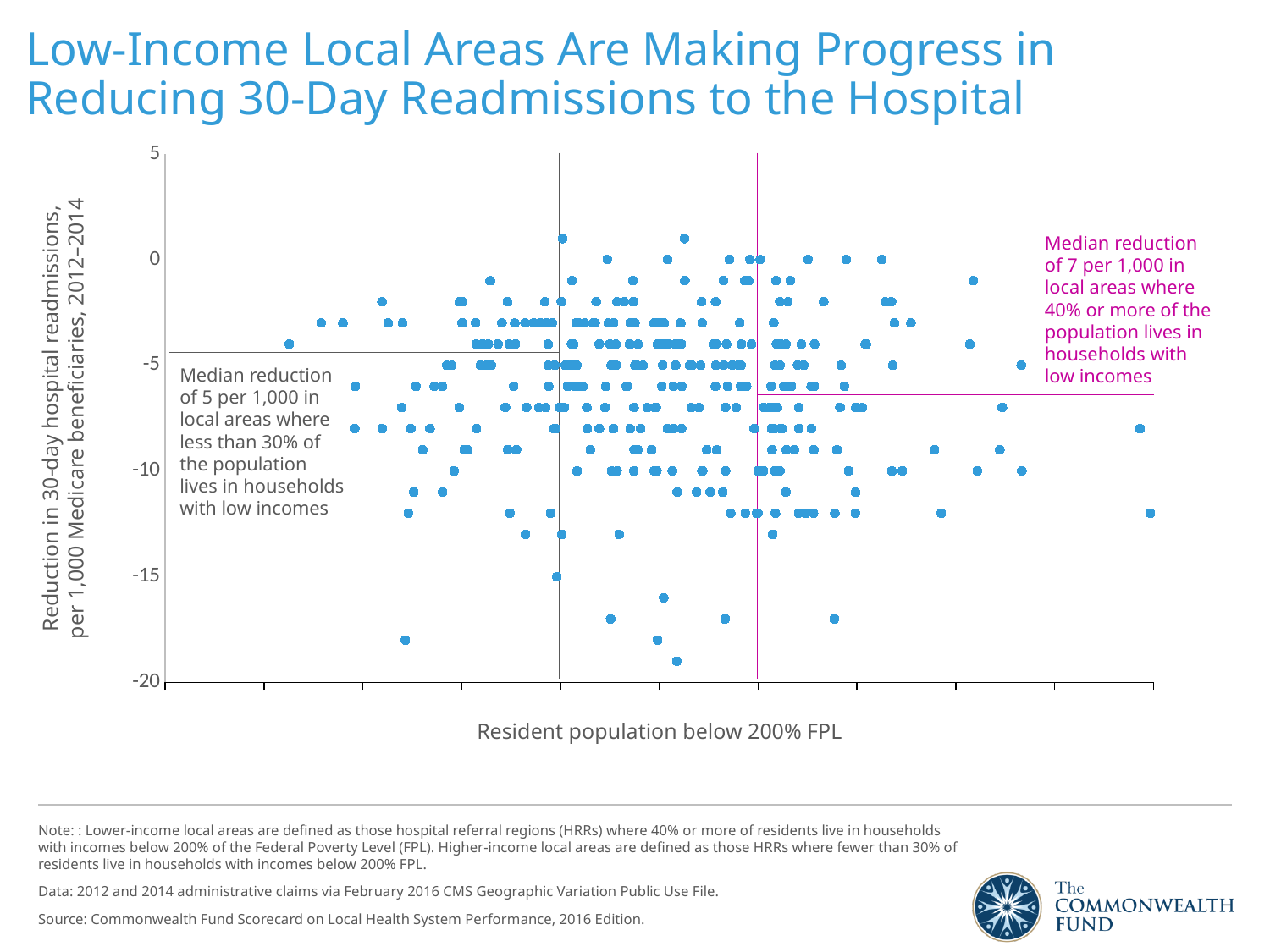
What is the title of the chart on the slide? Low-Income Local Areas Are Making Progress in Reducing 30-Day Readmissions to the Hospital Is the lowest plotted point on the chart greater or less than -15? less What is the highest value shown on the y axis? 5 What is the lowest value shown on the y axis? -20 What is the label of the x axis? Resident population below 200% FPL According to the annotation, what is the median reduction in local areas where 40% or more of the population lives in households with low incomes? 7 per 1,000 Which group has the larger median reduction: areas where less than 30% of the population has low incomes, or areas where 40% or more has low incomes? Areas where 40% or more has low incomes Over what years does the y axis say the reduction in 30-day hospital readmissions was measured? 2012–2014 What is the difference between the median reduction for low-income areas (40% or more) and higher-income areas (less than 30%)? 2 per 1,000 Is the highest plotted point on the chart greater or less than 0? greater According to the annotation, what is the median reduction in local areas where less than 30% of the population lives in households with low incomes? 5 per 1,000 What kind of chart is shown on the slide? Scatter plot